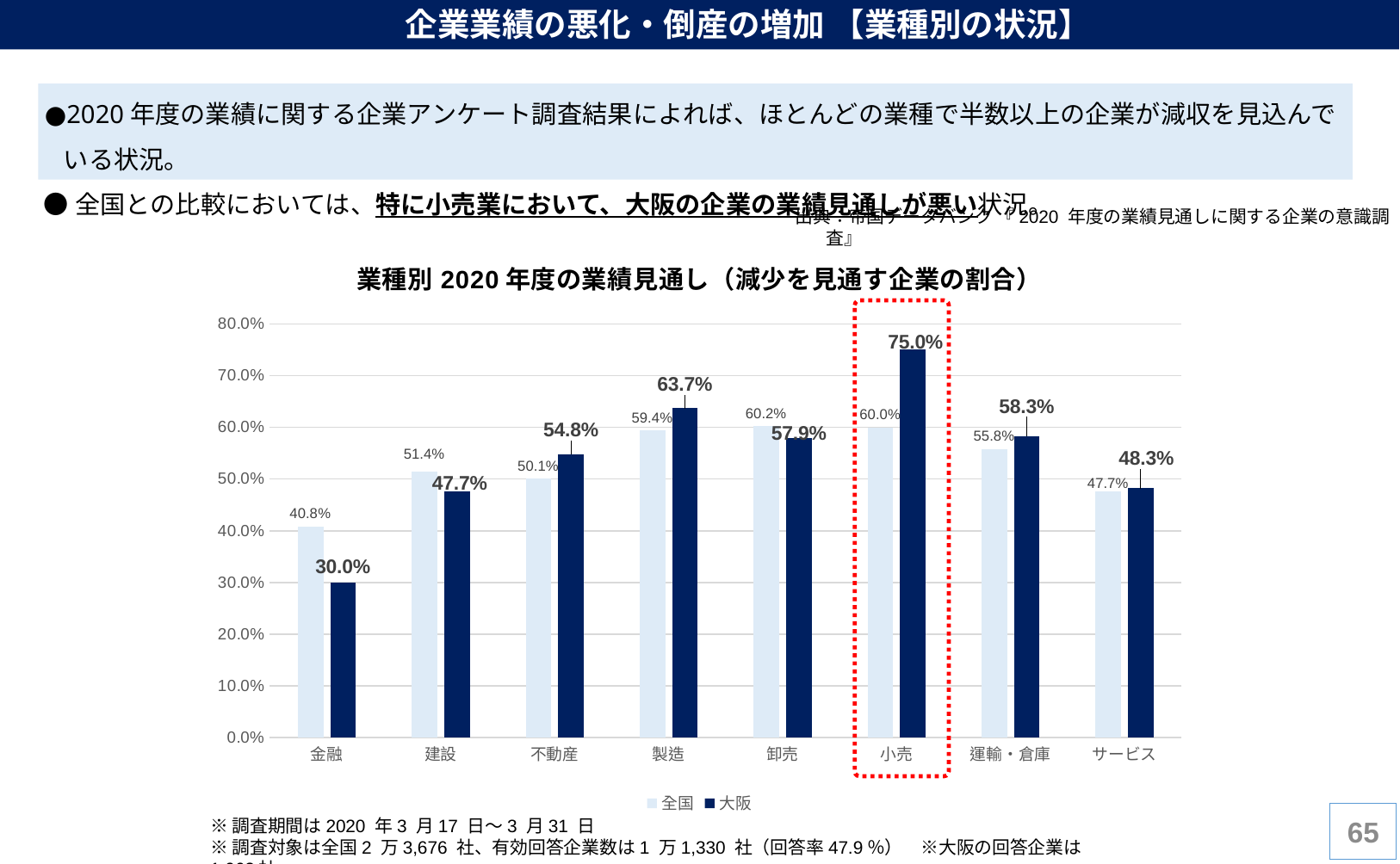
What is the value for 大阪 in the 製造 category? 63.7% Which category has the lowest value for 大阪? 金融 What kind of chart is shown on the slide? bar chart How many categories are shown on the x axis? 8 What is the title of the chart? 業種別 2020 年度の業績見通し（減少を見通す企業の割合） How many series does the legend list? 2 Which category has the lowest value for 全国? 金融 What is the value for 大阪 in the 小売 category? 75.0% What is the value for 全国 in the 金融 category? 40.8% In the 金融 category, which is larger, the 全国 value or the 大阪 value? 全国 Which category has the highest value for 大阪? 小売 What is the difference between the 大阪 and 全国 values in the 小売 category? 15.0%